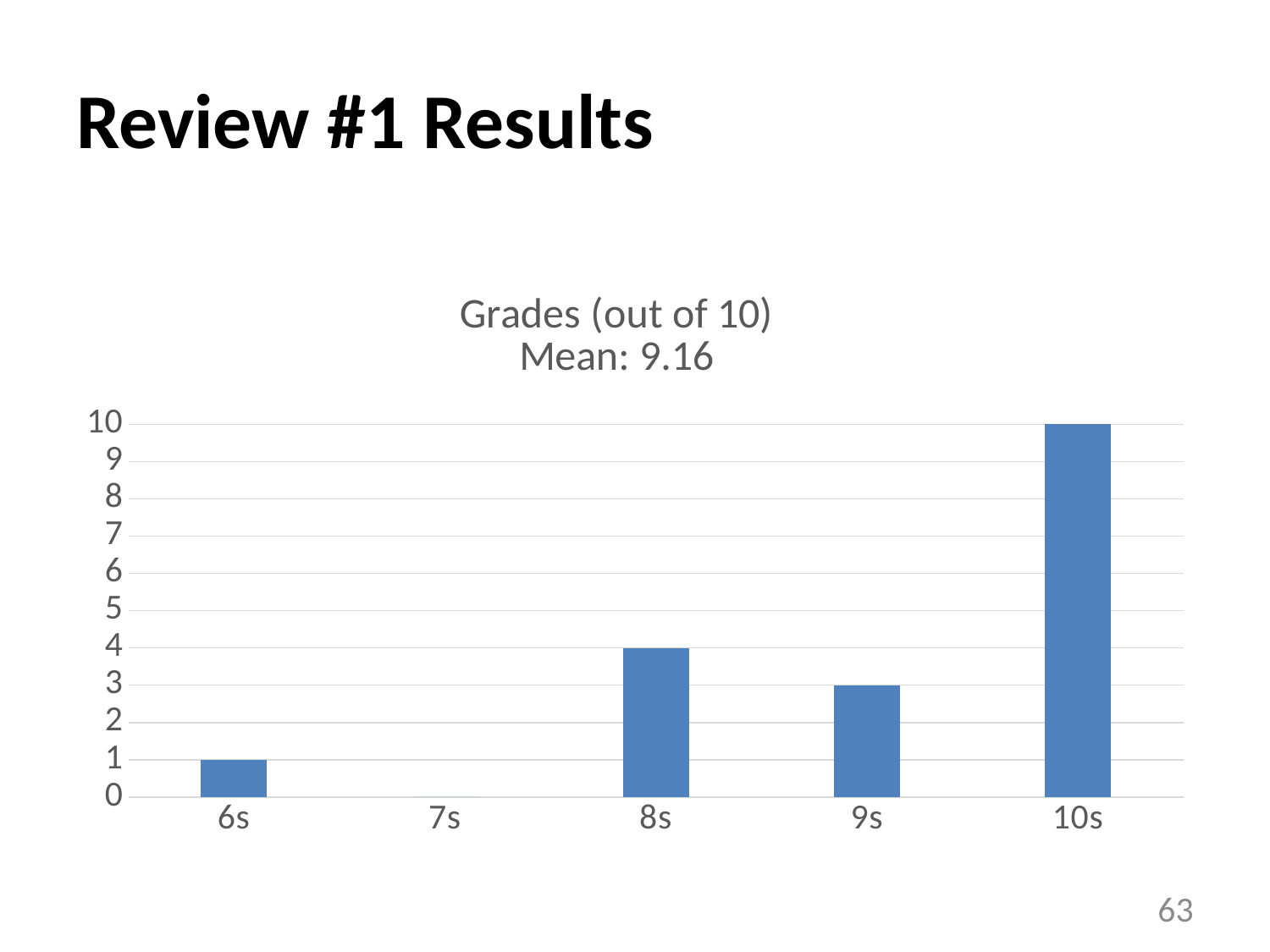
What is the difference between the values for 10s and 8s? 6 What is the value for the 6s category? 1 What is the value for the 7s category? 0 What type of chart is shown on the slide? bar chart What is the value for the 8s category? 4 Which is larger, the value for 8s or the value for 9s? 8s How many categories are shown on the x axis of the chart? 5 What is the value for the 9s category? 3 Which category has the highest value? 10s What mean is stated in the chart title? 9.16 Which category has the lowest value? 7s What is the value for the 10s category? 10